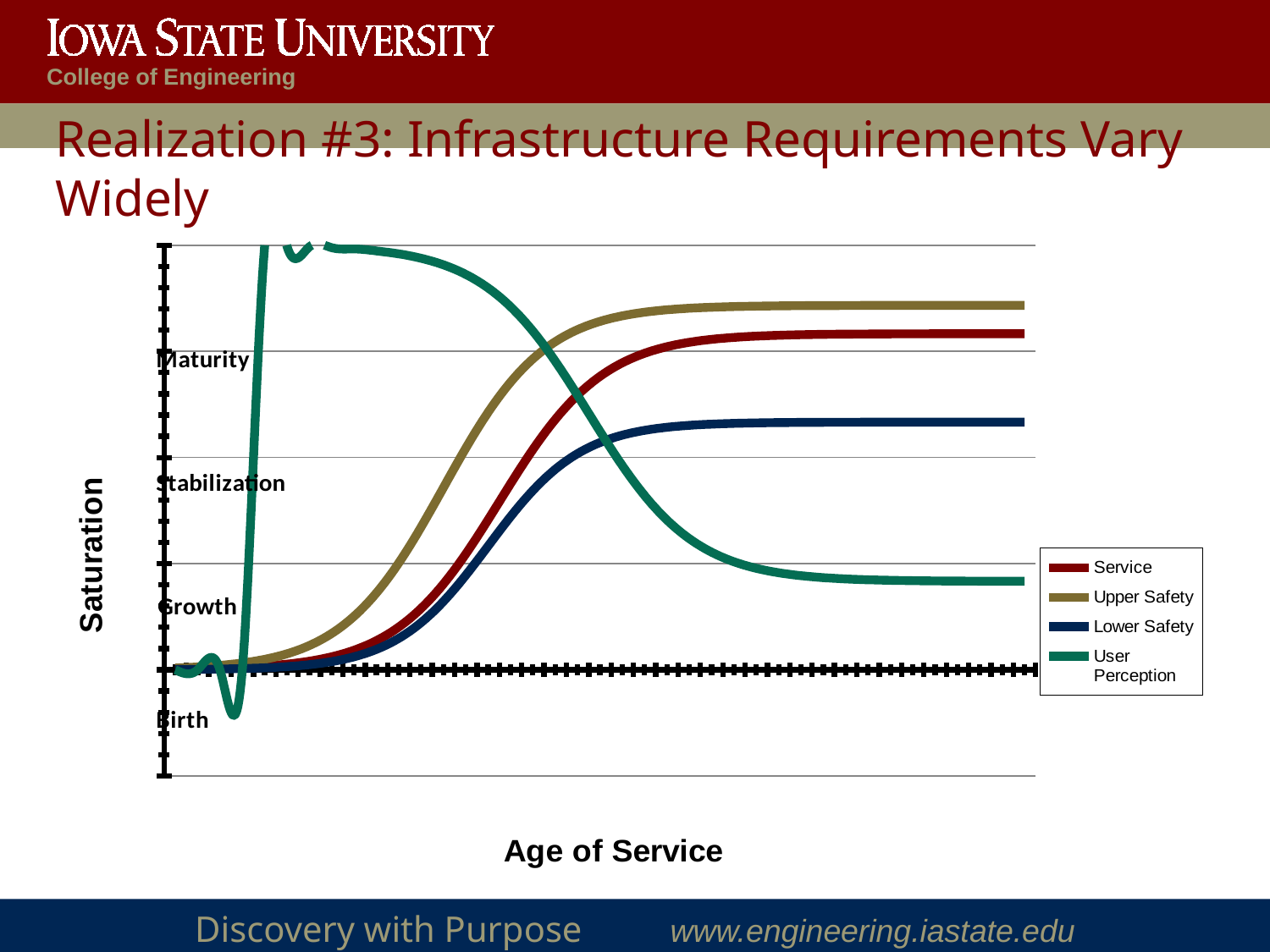
How many series does the legend list? 4 Does the Lower Safety series rise or fall as Age of Service increases? Rise At the right end of the chart, which is higher: Upper Safety or Service? Upper Safety Which series reaches the top of the chart early and then falls as Age of Service increases? User Perception At the right end of the chart, which is higher: Service or Lower Safety? Service Does the Service series rise or fall as Age of Service increases? Rise Which series has the lowest saturation at the right end of the chart? User Perception What kind of chart is shown on the slide? Line chart Which series is drawn in dark red? Service What is the title of the vertical axis? Saturation What is the title of the horizontal axis? Age of Service Which series has the highest saturation at the right end of the chart? Upper Safety